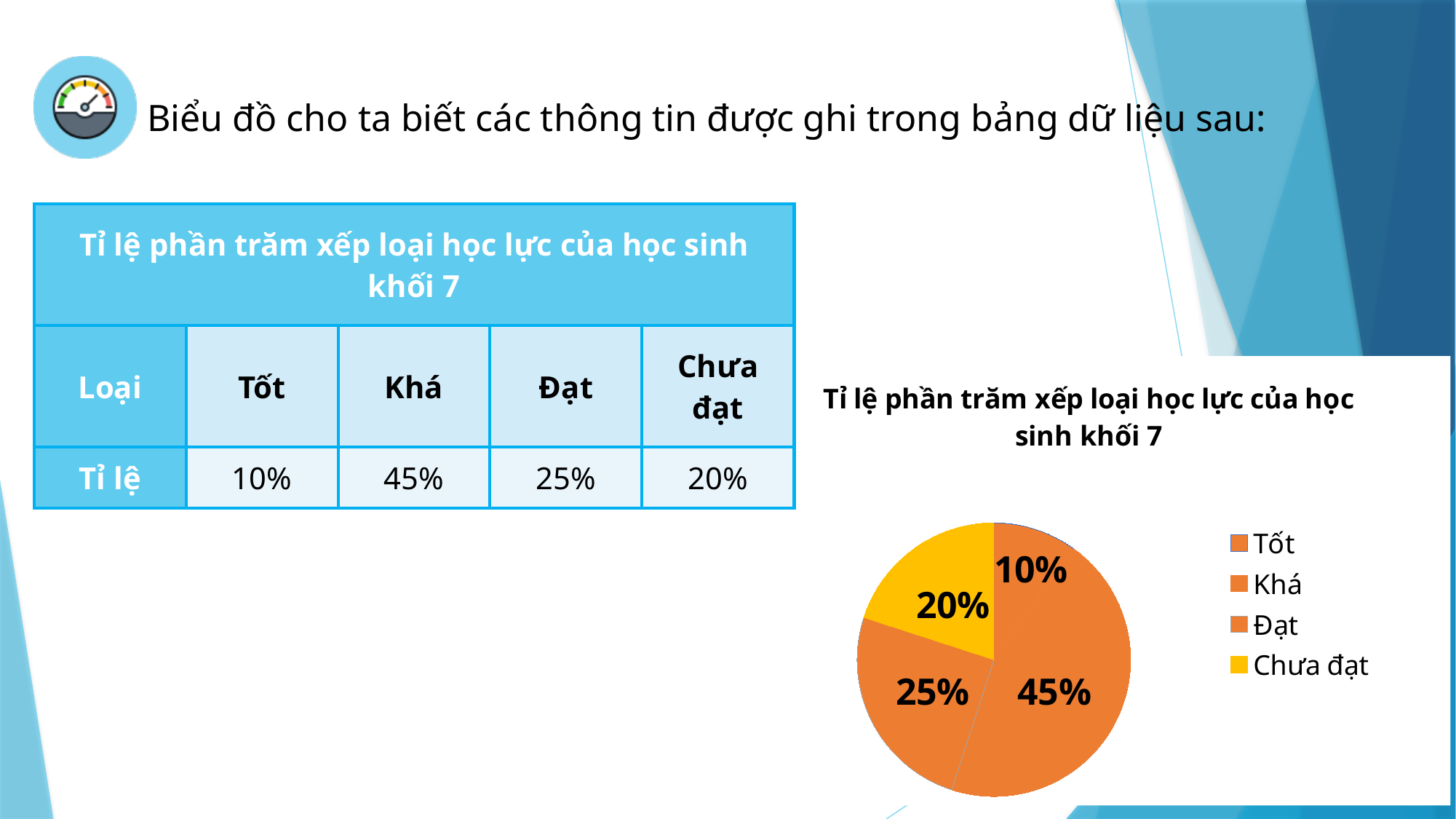
Which is larger in the pie chart, the share for Đạt or the share for Chưa đạt? Đạt Which category has the smallest slice in the pie chart? Tốt What is the share of the pie chart for Khá? 45% What is the title of the pie chart? Tỉ lệ phần trăm xếp loại học lực của học sinh khối 7 What is the share of the pie chart for Chưa đạt? 20% What is the share of the pie chart for Tốt? 10% Which category has the largest slice in the pie chart? Khá What is the difference between the shares for Khá and Đạt in the pie chart? 20% What kind of chart is shown on the slide? pie chart How many entries does the legend of the pie chart list? 4 How many slices does the pie chart have? 4